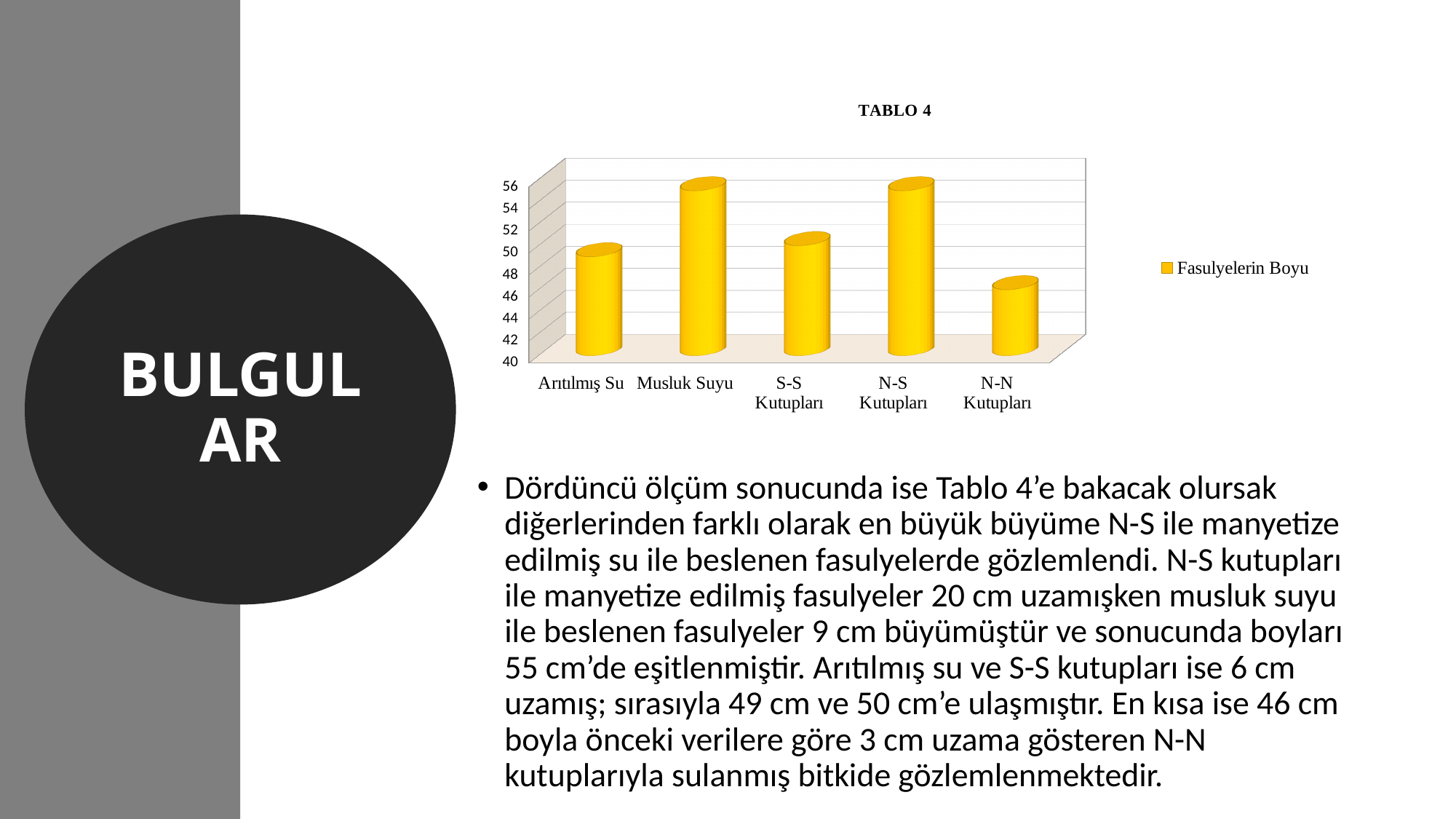
Is the value for Musluk Suyu in the TABLO 4 chart greater or less than 52? greater Is the value for N-N Kutupları in the TABLO 4 chart greater or less than 48? less What is the title of the chart on the slide? TABLO 4 Which is larger in the TABLO 4 chart, the bar for Arıtılmış Su or the bar for Musluk Suyu? Musluk Suyu Is the value for Arıtılmış Su in the TABLO 4 chart greater or less than 46? greater What is the legend entry of the TABLO 4 chart? Fasulyelerin Boyu How many categories are shown on the x axis of the TABLO 4 chart? 5 Which category has the lowest bar in the TABLO 4 chart? N-N Kutupları What kind of chart is shown under the title TABLO 4? bar chart Which is larger in the TABLO 4 chart, the bar for S-S Kutupları or the bar for N-N Kutupları? S-S Kutupları How many series does the legend of the TABLO 4 chart list? 1